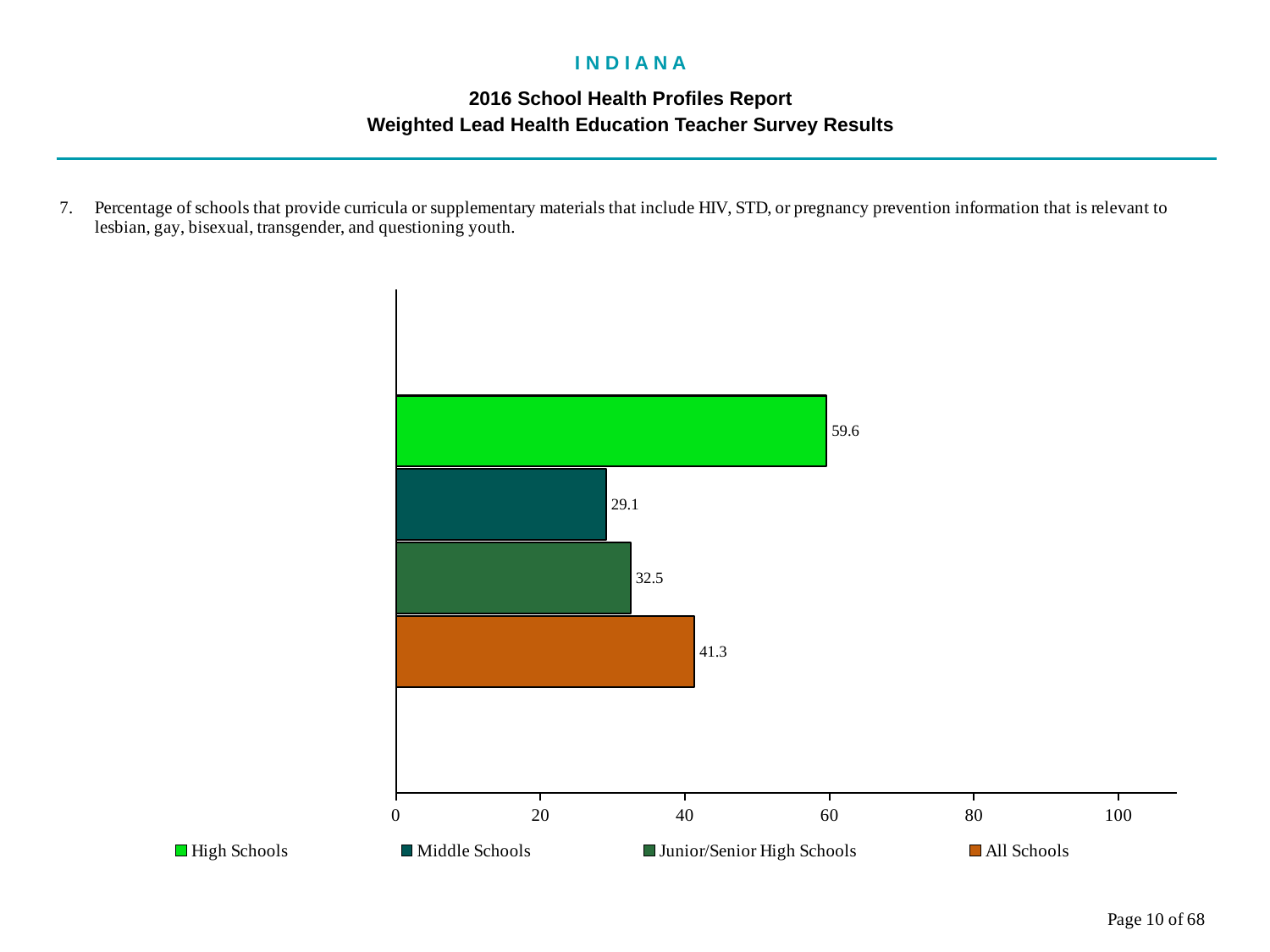
Which school type has the highest value? High Schools What is the value for Middle Schools? 29.1 What kind of chart is shown on the slide? bar chart What is the difference between the values for All Schools and Junior/Senior High Schools? 8.8 What is the difference between the values for High Schools and Middle Schools? 30.5 How many series does the legend list? 4 Which school type has the lowest value? Middle Schools What is the value for Junior/Senior High Schools? 32.5 Is the value for All Schools greater or less than 40? greater What is the value for High Schools? 59.6 What is the value for All Schools? 41.3 Which is larger, the value for Junior/Senior High Schools or the value for Middle Schools? Junior/Senior High Schools